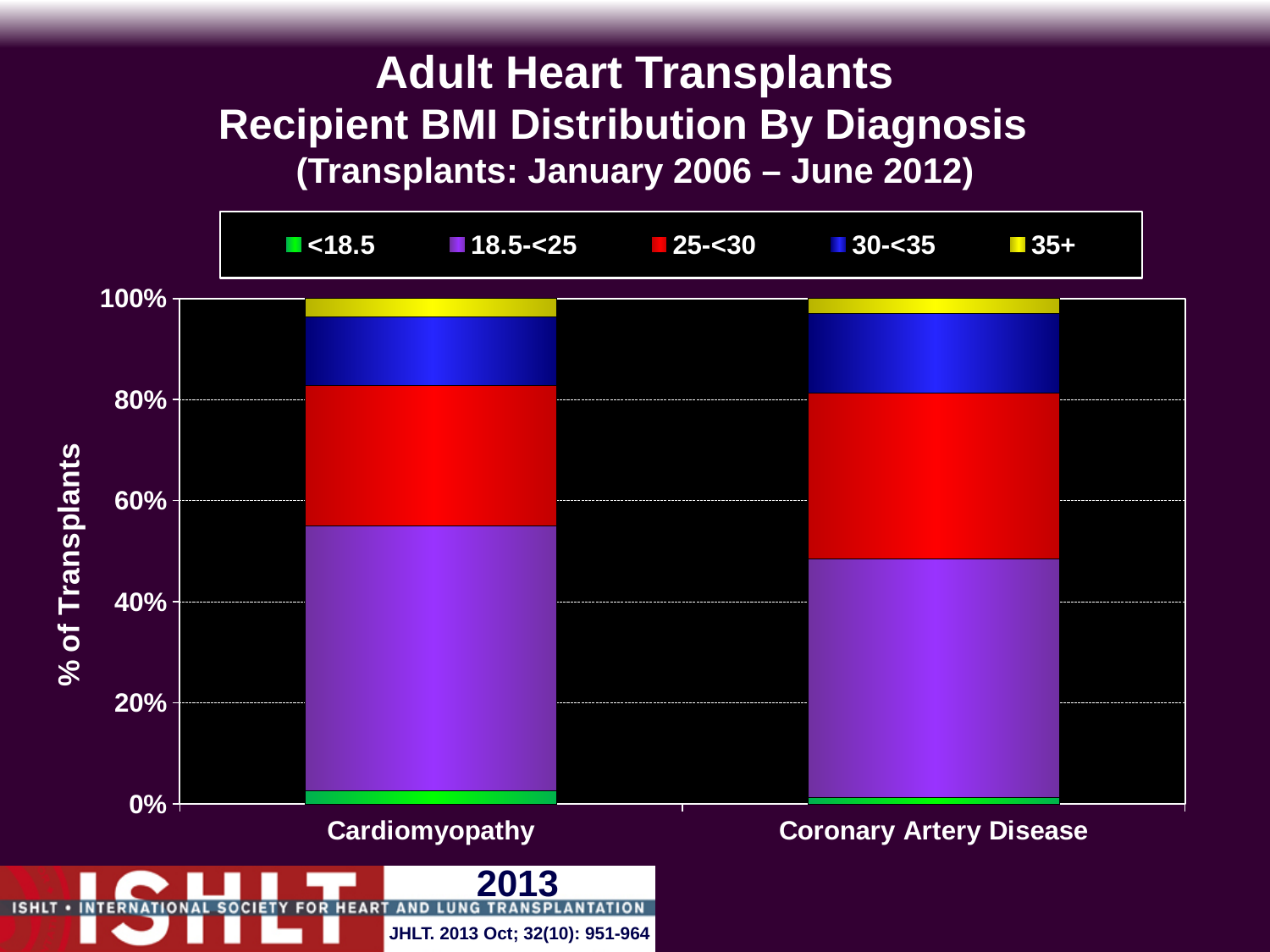
Which diagnosis has the larger share of recipients with BMI 18.5-<25, Cardiomyopathy or Coronary Artery Disease? Cardiomyopathy Is the <18.5 share of transplants for Cardiomyopathy greater or less than 20%? less Which BMI category makes up the largest segment of the Cardiomyopathy bar? 18.5-<25 How many BMI series does the legend list? 5 Is the 18.5-<25 share of transplants for Coronary Artery Disease greater or less than 60%? less Which BMI category makes up the smallest segment of the Coronary Artery Disease bar? <18.5 Which colour represents the 35+ BMI category in the legend? yellow How many diagnosis categories are shown on the x axis? 2 What is the label of the y axis? % of Transplants What kind of chart is shown on the slide? stacked bar chart Is the 18.5-<25 share of transplants for Cardiomyopathy greater or less than 40%? greater Which diagnosis has the larger share of recipients with BMI 25-<30, Cardiomyopathy or Coronary Artery Disease? Coronary Artery Disease